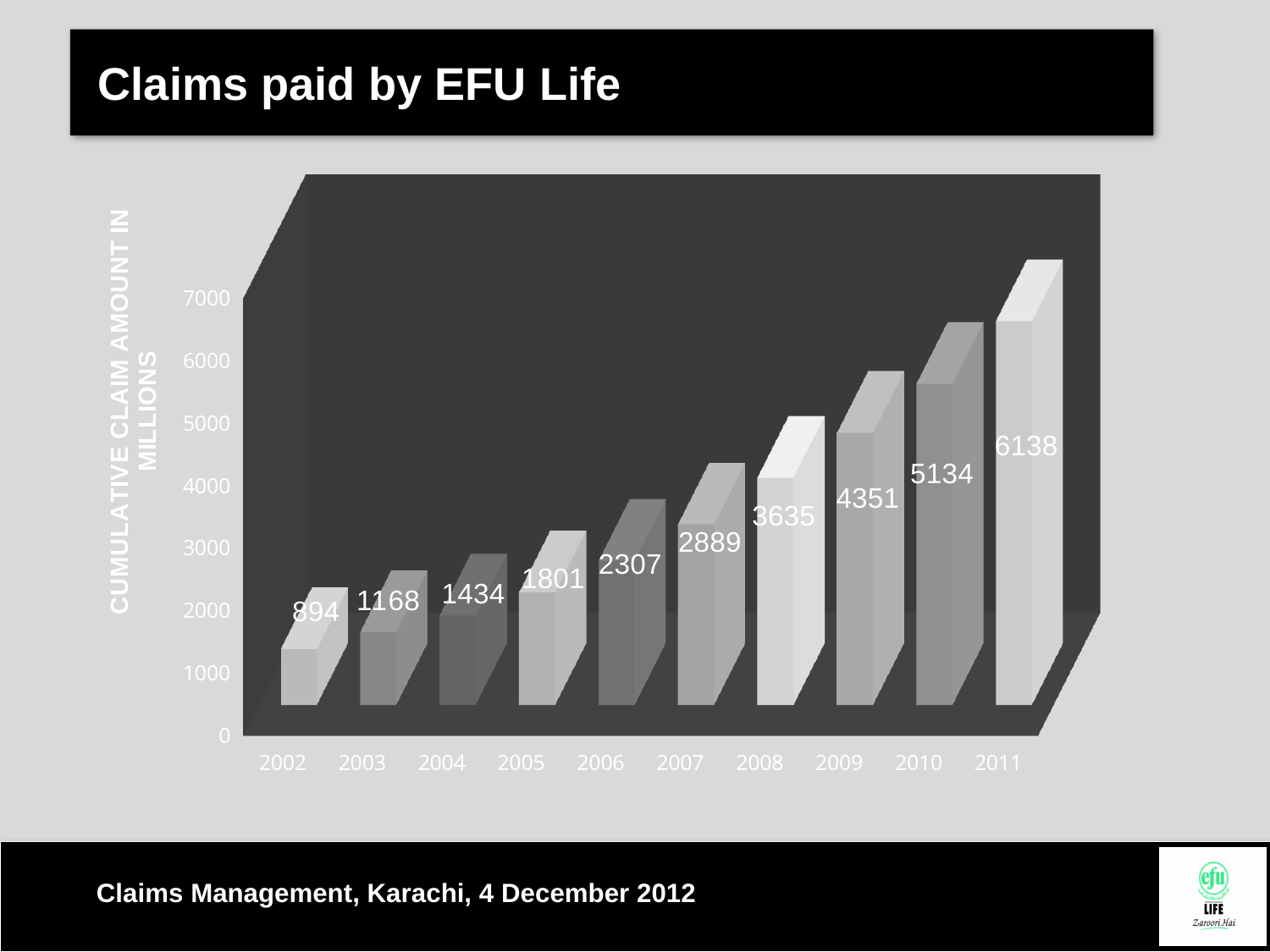
What is the cumulative claim amount for 2010? 5134 Which year has the highest cumulative claim amount? 2011 What is the difference between the cumulative claim amounts for 2008 and 2007? 746 What is the cumulative claim amount for 2007? 2889 What kind of chart is shown on the slide? Bar chart How many years are shown on the x axis? 10 Do the cumulative claim amounts rise or fall from 2002 to 2011? Rise What is the label of the vertical axis? CUMULATIVE CLAIM AMOUNT IN MILLIONS Which year has the lowest cumulative claim amount? 2002 Which year has a larger cumulative claim amount, 2005 or 2006? 2006 What is the cumulative claim amount for 2002? 894 What is the difference between the cumulative claim amounts for 2011 and 2010? 1004